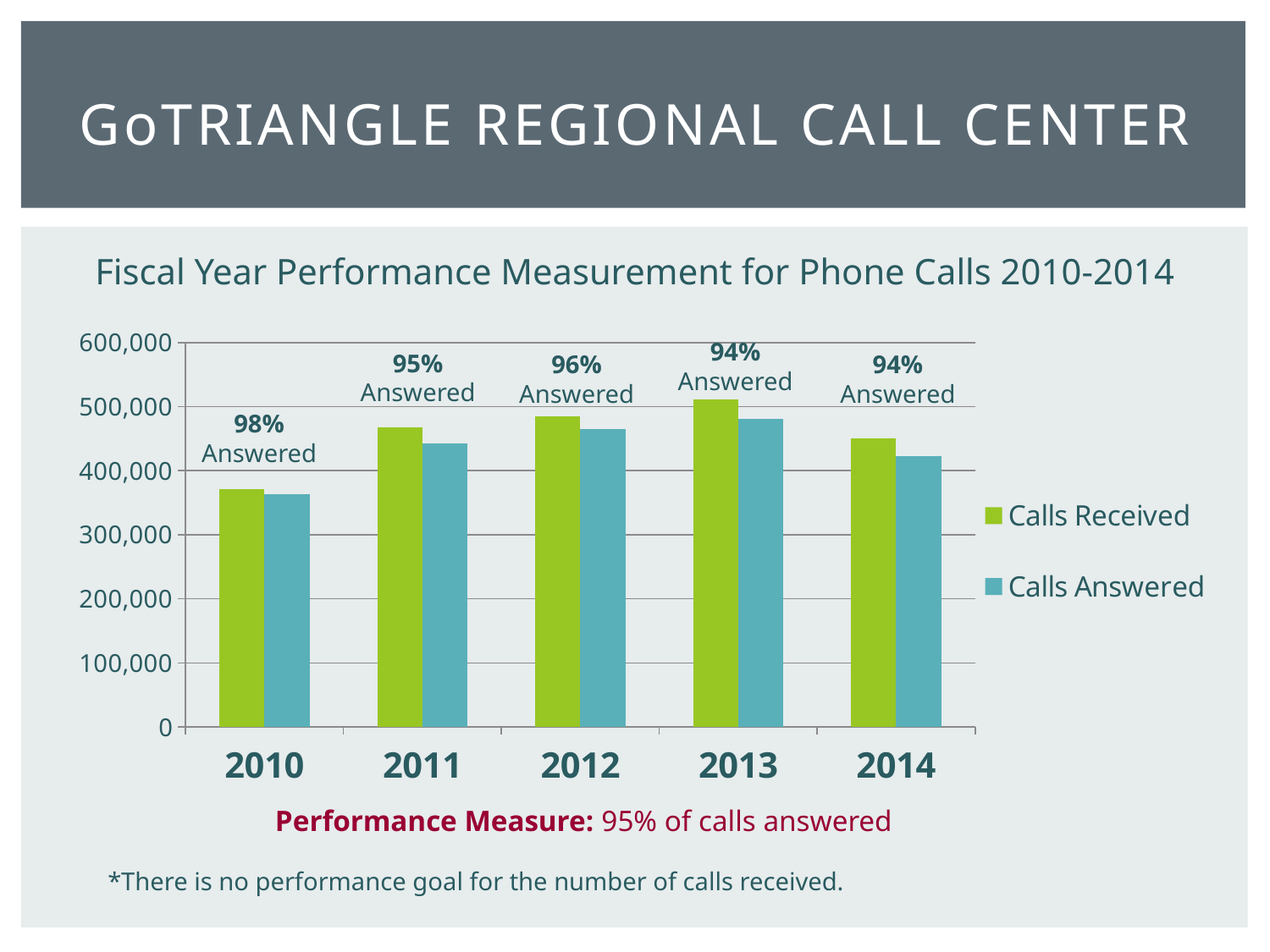
How many series does the legend list? 2 Which year has the lowest number of Calls Received? 2010 Which year had more Calls Received, 2012 or 2014? 2012 Is the value for Calls Answered in 2010 greater or less than 400,000? less How many fiscal years are shown on the x axis? 5 Is the value for Calls Received in 2013 greater or less than 500,000? greater What is the title of the chart? Fiscal Year Performance Measurement for Phone Calls 2010-2014 Which year has the highest percentage of calls answered? 2010 Which year has the highest number of Calls Received? 2013 What kind of chart is shown on the slide? bar chart What percentage of calls were answered in 2010? 98% What percentage of calls were answered in 2012? 96%